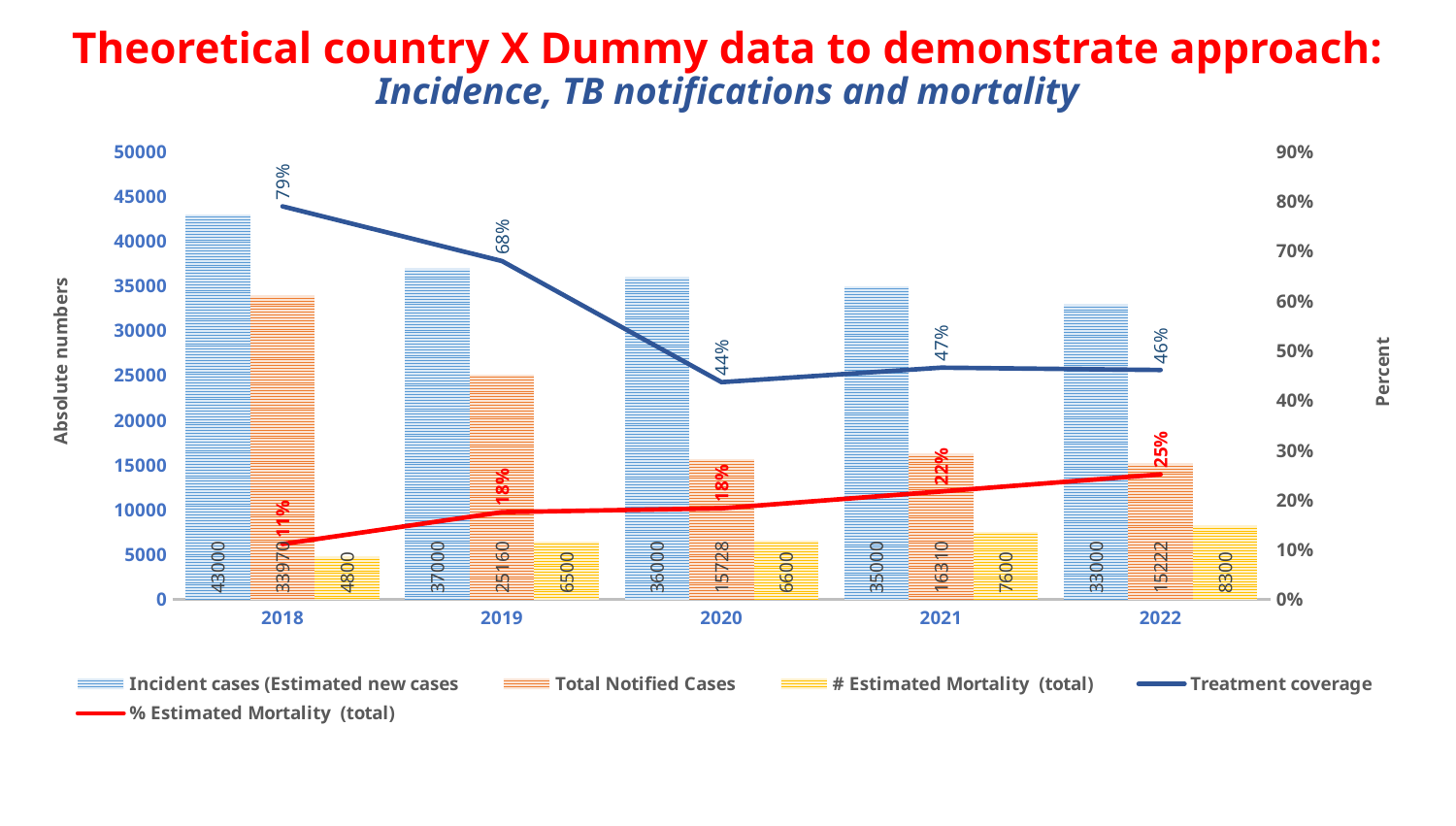
In which year is # Estimated Mortality (total) highest? 2022 What is the value of Total Notified Cases in 2020? 15728 What is the label of the right-hand vertical axis? Percent In which year is Treatment coverage lowest? 2020 How many series does the legend list? 5 What is the difference between Incident cases (Estimated new cases) and Total Notified Cases in 2021? 18690 Does Incident cases (Estimated new cases) rise or fall from 2018 to 2022? fall What is the % Estimated Mortality (total) in 2022? 25% What is the value of Incident cases (Estimated new cases) in 2018? 43000 How many years are shown on the x axis? 5 What is the Treatment coverage in 2019? 68% Which is larger: Total Notified Cases in 2019 or Total Notified Cases in 2021? Total Notified Cases in 2019